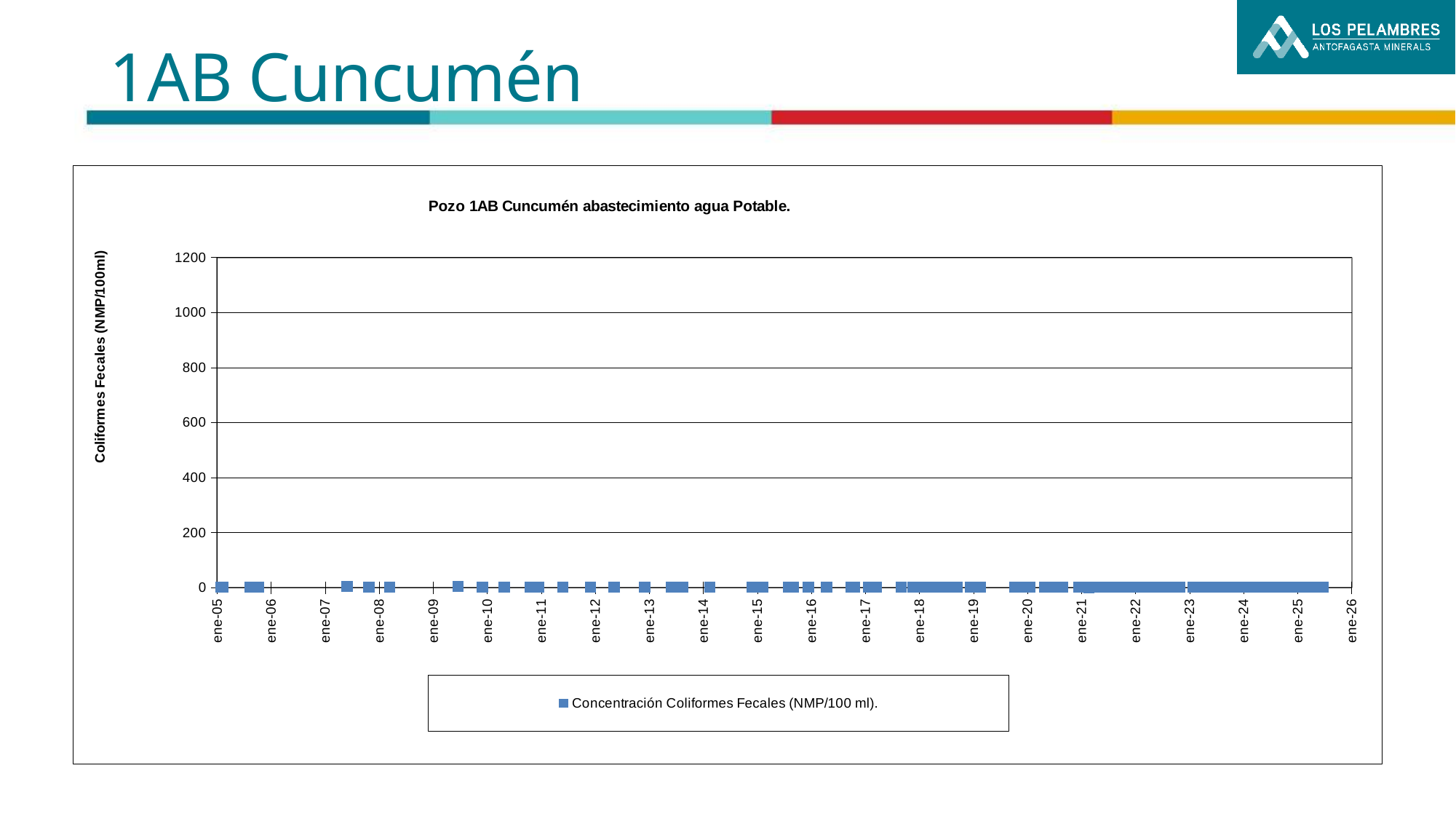
What is the title of the chart? Pozo 1AB Cuncumén abastecimiento agua Potable. Do the values rise, fall, or stay flat from ene-05 to ene-25? stay flat What is the first label on the x axis? ene-05 How many series does the legend list? 1 How many labels are shown on the x axis? 22 What is the highest tick value shown on the y axis? 1200 Is the value for ene-10 greater or less than 200? less Is the value for ene-20 greater or less than 400? less What is the last label on the x axis? ene-26 What kind of chart is shown on the slide? line chart What is the name of the series shown in the legend? Concentración Coliformes Fecales (NMP/100 ml).